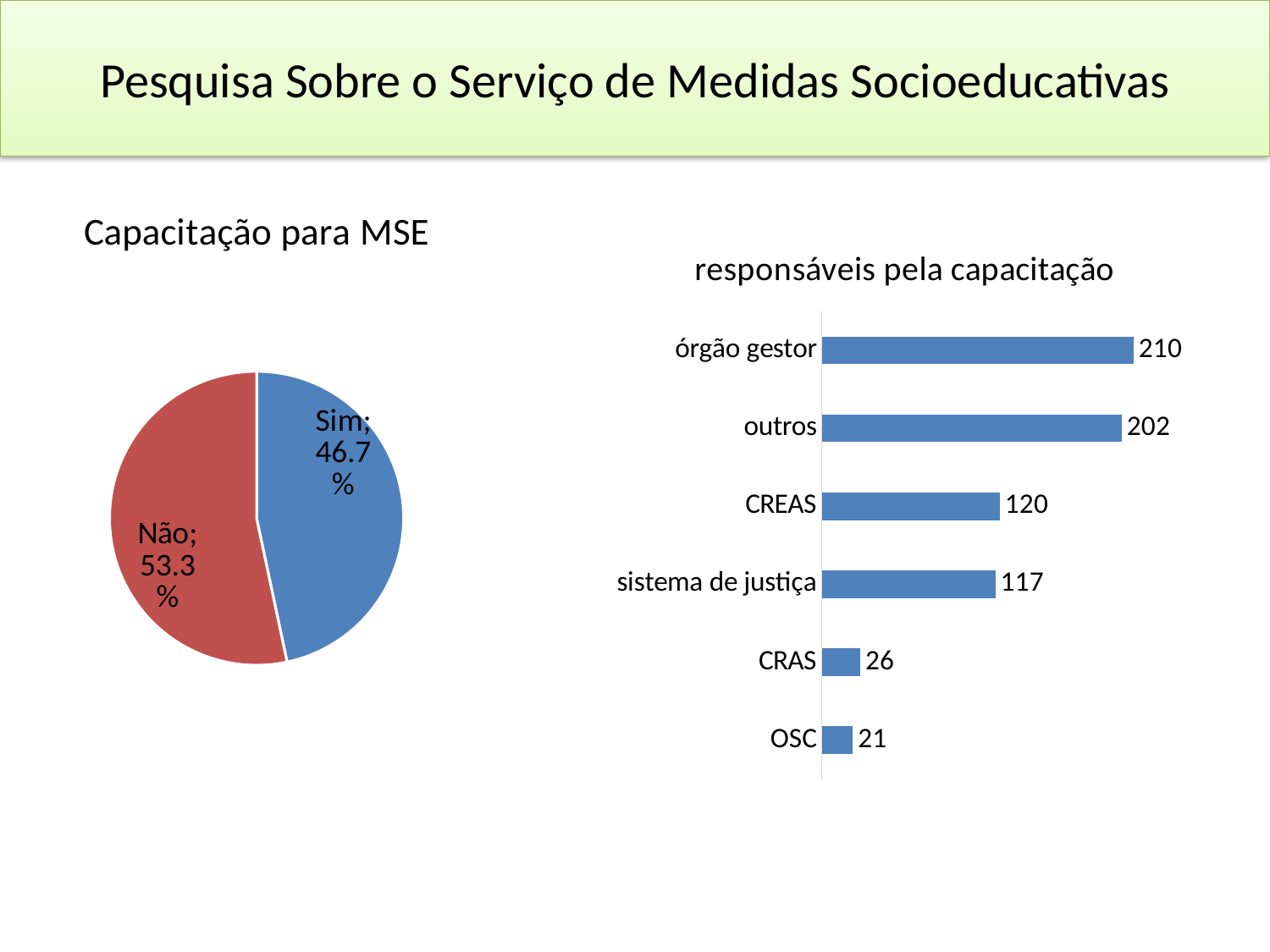
In the 'Capacitação para MSE' pie chart, what share does the Não slice have? 53.3% In the 'Capacitação para MSE' pie chart, what is the value for Sim? 46.7% What kind of chart is the 'Capacitação para MSE' chart? pie chart In the 'responsáveis pela capacitação' chart, what is the difference between the values for órgão gestor and outros? 8 In the 'responsáveis pela capacitação' chart, which is larger, the value for CREAS or the value for sistema de justiça? CREAS In the 'responsáveis pela capacitação' chart, what is the value for CRAS? 26 How many categories are shown in the 'responsáveis pela capacitação' chart? 6 What kind of chart is the 'responsáveis pela capacitação' chart? bar chart In the 'responsáveis pela capacitação' chart, which category has the lowest value? OSC In the 'responsáveis pela capacitação' chart, what is the value for órgão gestor? 210 In the 'responsáveis pela capacitação' chart, which category has the highest value? órgão gestor In the 'Capacitação para MSE' pie chart, which slice is larger, Sim or Não? Não